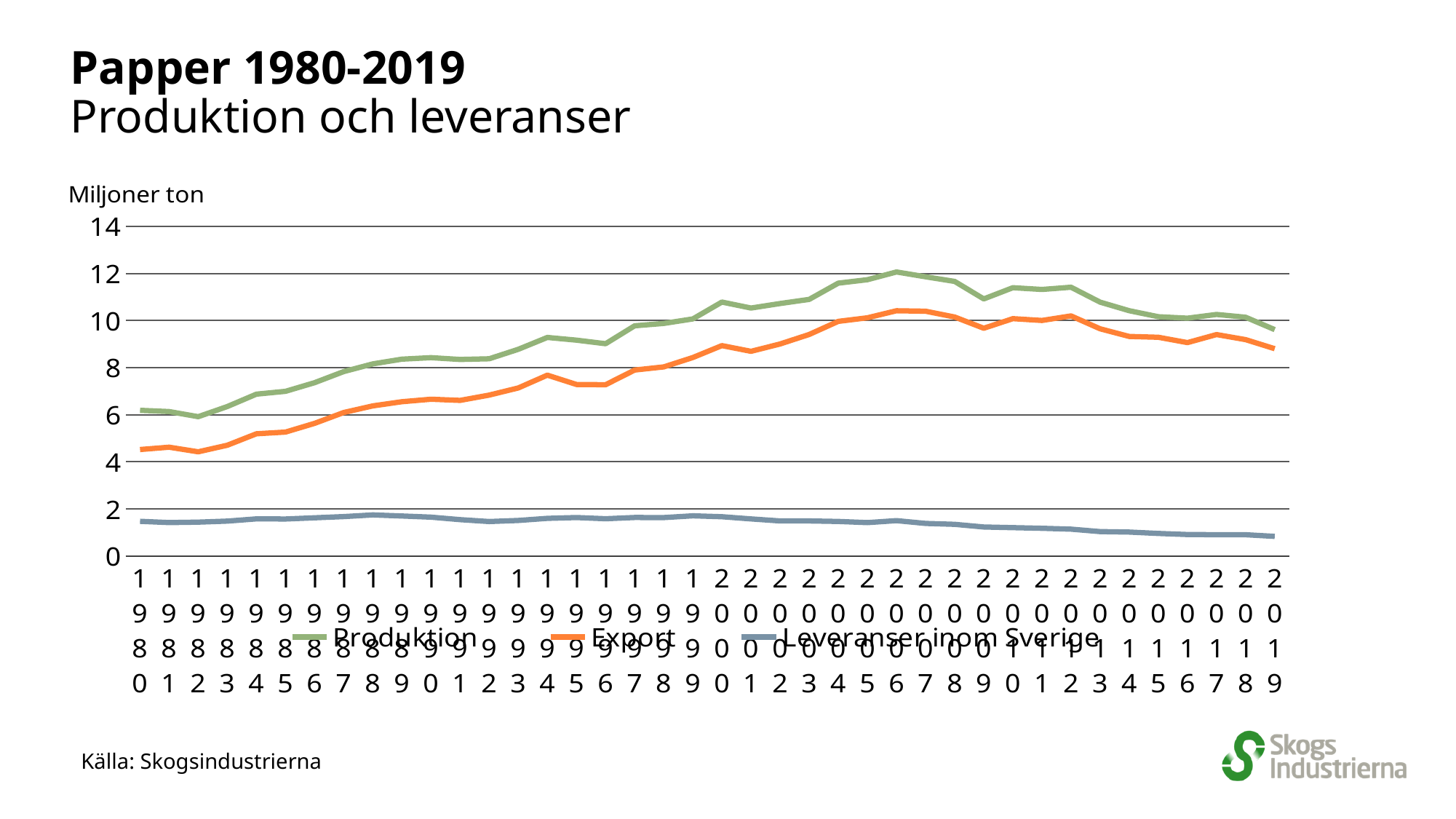
Is the value for Export in 1980 greater or less than 6? less Which series has the lowest value in 1995? Leveranser inom Sverige How many series does the legend list? 3 What unit is shown on the y axis? Miljoner ton Which series has the highest value in 2010? Produktion Is the value for Produktion in 2006 greater or less than 10? greater Does the Produktion series rise or fall between 1980 and 2006? rise Which is larger in 2000, Produktion or Export? Produktion How many years are plotted along the x axis? 40 What kind of chart is shown on the slide? line chart Is the value for Leveranser inom Sverige in 2019 greater or less than 2? less